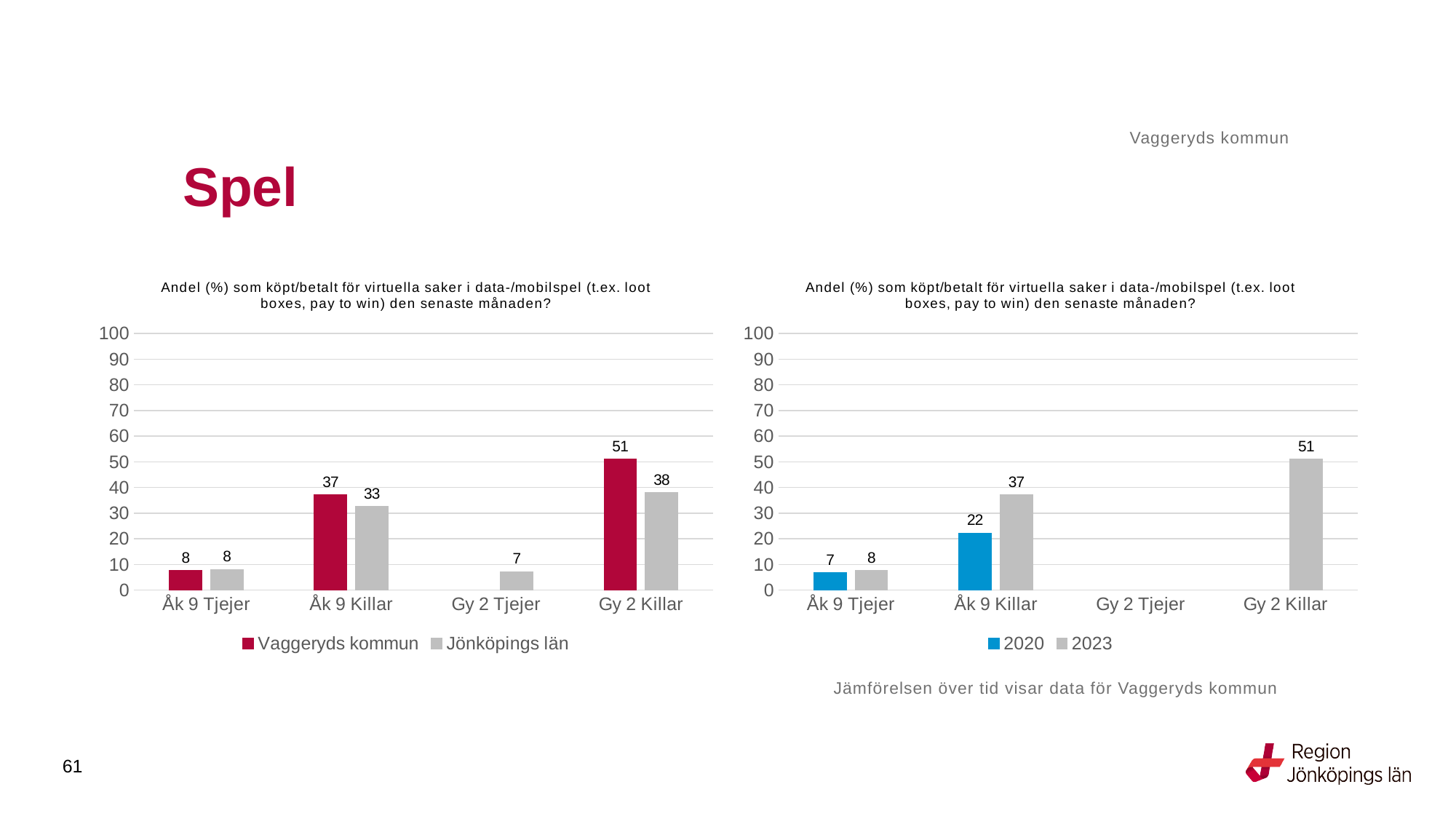
In the left chart, what is the difference between Vaggeryds kommun and Jönköpings län for Gy 2 Killar? 13 In the left chart, how many series does the legend list? 2 In the right chart, which category has the lowest value for 2020? Åk 9 Tjejer In the right chart, which two years does the legend list? 2020 and 2023 In the right chart, what is the difference between 2023 and 2020 for Åk 9 Killar? 15 In the left chart, which is larger for Åk 9 Killar: Vaggeryds kommun or Jönköpings län? Vaggeryds kommun In the left chart, which category has the highest value for Vaggeryds kommun? Gy 2 Killar In the right chart, what is the value for 2023 for Gy 2 Killar? 51 In the right chart, what is the value for 2020 for Åk 9 Killar? 22 In the left chart, what is the value for Vaggeryds kommun for Åk 9 Killar? 37 In the left chart, what is the value for Jönköpings län for Gy 2 Tjejer? 7 What kind of chart is the right chart? Bar chart